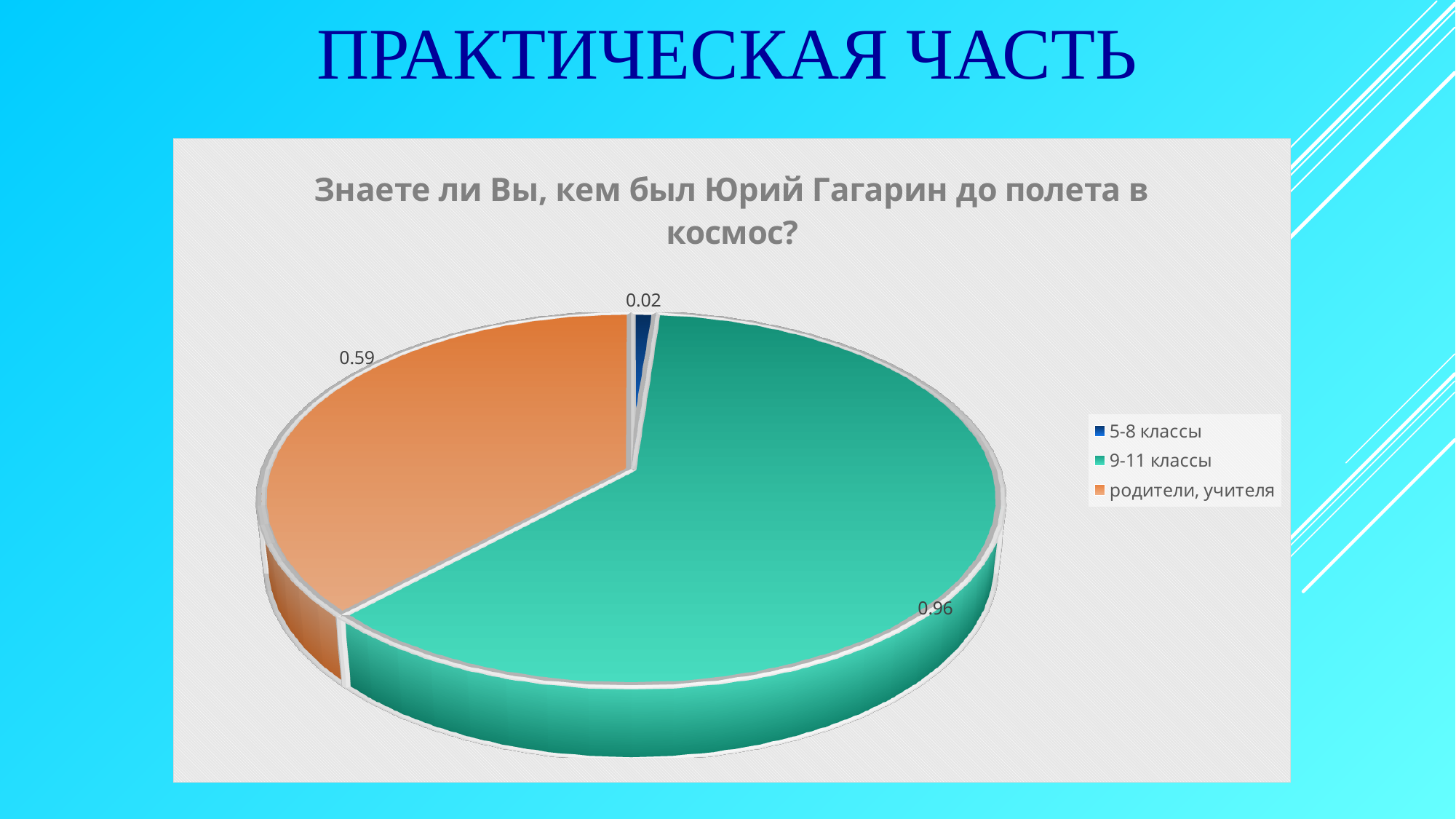
How many slices does the pie chart have? 3 Which category has the lowest value in the pie chart? 5-8 классы What is the difference between the values for 9-11 классы and родители, учителя? 0.37 What kind of chart is shown on the slide? Pie chart What value is shown for the 9-11 классы slice? 0.96 Which is larger: the value for родители, учителя or the value for 5-8 классы? родители, учителя Which category has the highest value in the pie chart? 9-11 классы What value is shown for the 5-8 классы slice? 0.02 How many entries does the legend list? 3 What is the title of the chart? Знаете ли Вы, кем был Юрий Гагарин до полета в космос? What value is shown for the родители, учителя slice? 0.59 What is the difference between the values for родители, учителя and 5-8 классы? 0.57